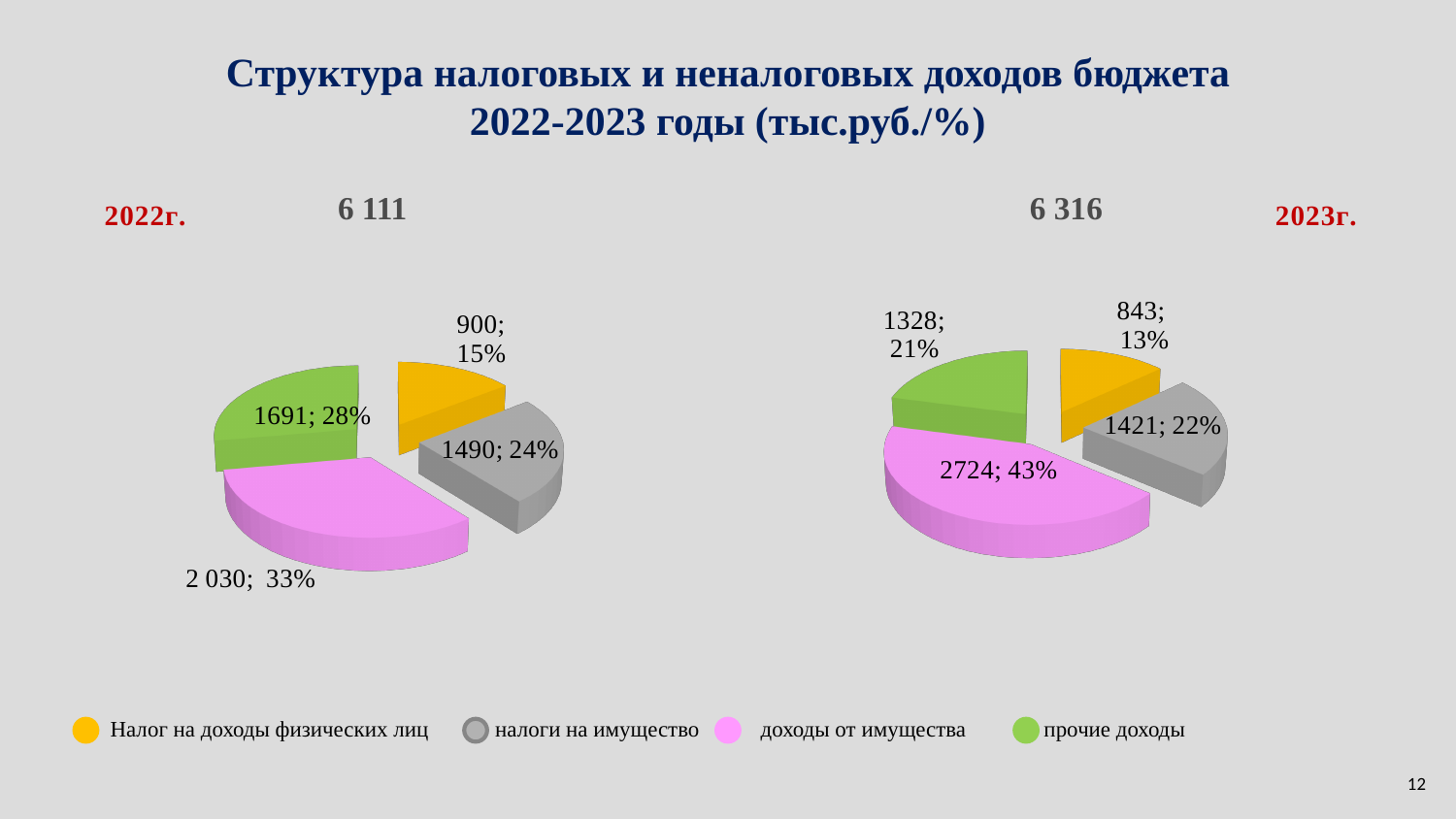
On the 2023г. pie chart, which category has the smallest slice? Налог на доходы физических лиц Which is larger: прочие доходы in 2022г. or прочие доходы in 2023г.? прочие доходы in 2022г. On the 2022г. pie chart, what value is shown for доходы от имущества? 2 030; 33% What type of chart is used on this slide? Pie chart On the 2023г. pie chart, what value is shown for Налог на доходы физических лиц? 843; 13% What total is shown above the 2023г. pie chart? 6 316 What is the difference between the 2023г. and 2022г. values for налоги на имущество? 69 On the 2022г. pie chart, what share of the pie does налоги на имущество take? 24% On the 2023г. pie chart, what value is shown for прочие доходы? 1328; 21% On the 2023г. pie chart, what share of the pie does доходы от имущества take? 43% On the 2022г. pie chart, which category has the largest slice? доходы от имущества How many slices does the 2022г. pie chart have? 4